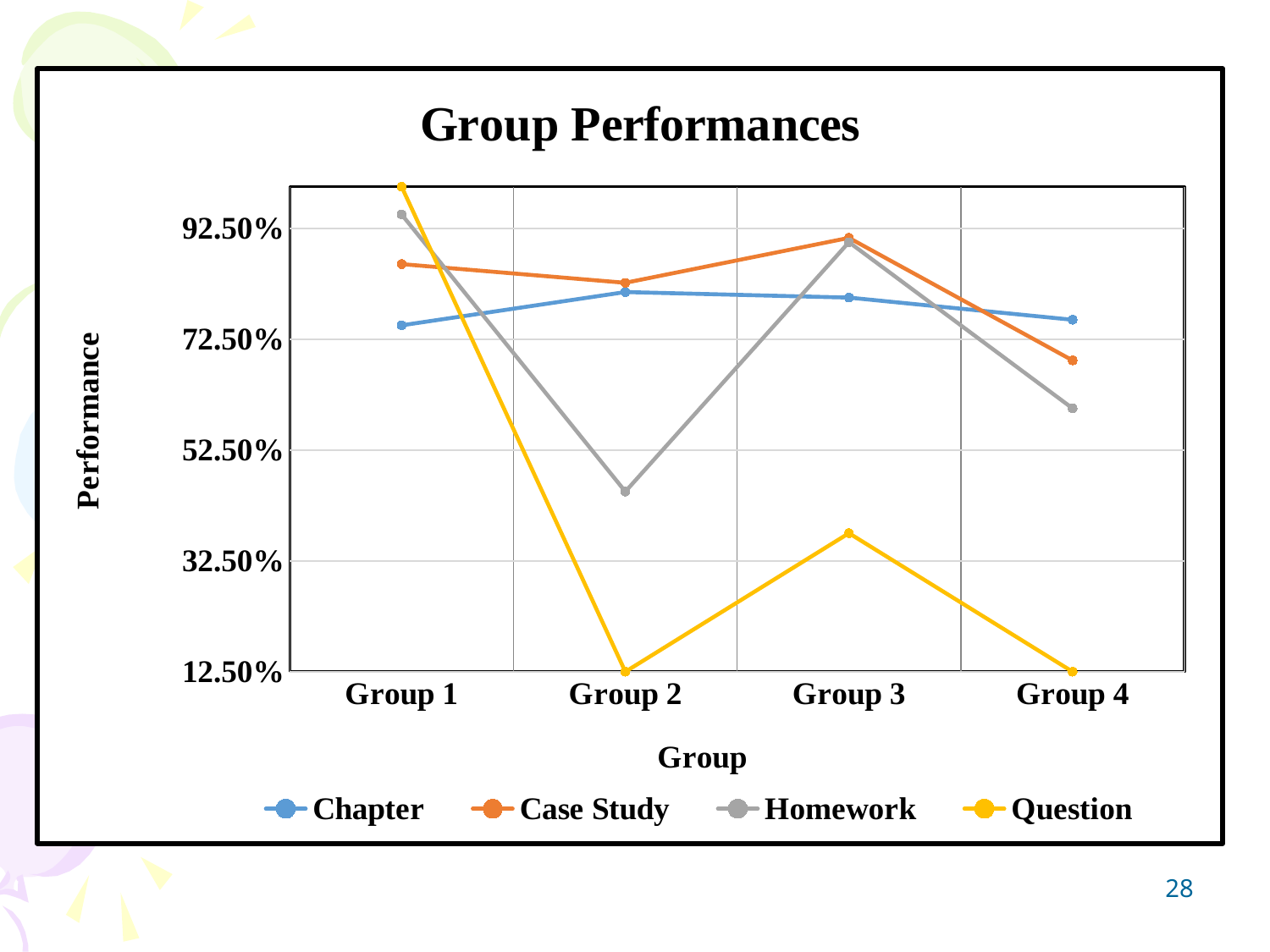
How many groups are shown on the x axis? 4 What is the title of the chart? Group Performances What is the Question value for Group 2? 12.50% Does the Question series rise or fall from Group 1 to Group 2? fall What kind of chart is shown on the slide? line chart For Group 1, which is larger: the Homework value or the Chapter value? Homework How many series does the legend list? 4 For which group is the Case Study value highest? Group 3 For which group is the Homework value lowest? Group 2 Is the Case Study value for Group 4 greater or less than 72.50%? less Is the Homework value for Group 2 greater or less than 52.50%? less Is the Question value for Group 3 greater or less than 32.50%? greater